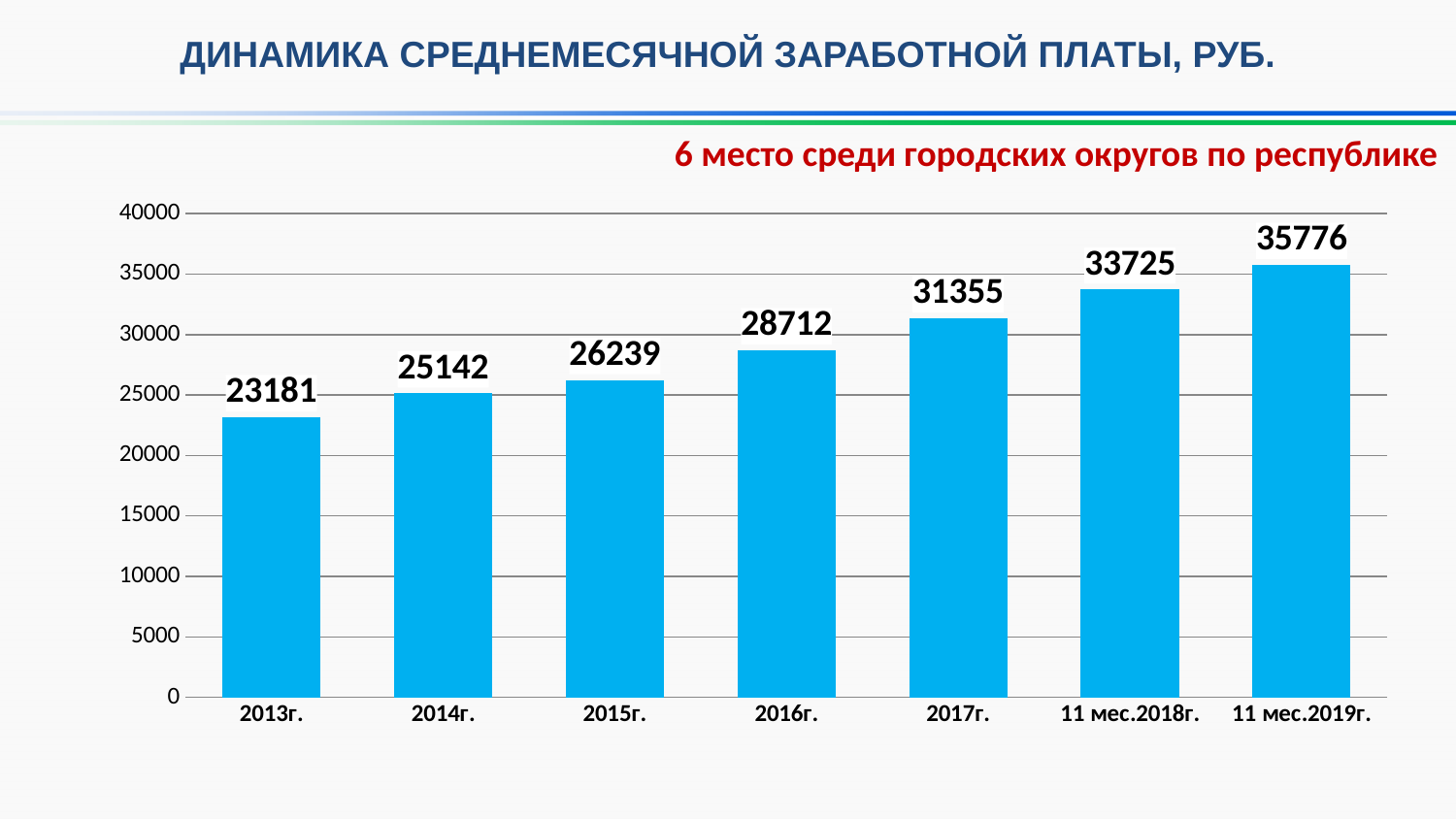
What is the average monthly salary value shown for 2013г.? 23181 Which category has the lowest value? 2013г. Which category has the highest value? 11 мес.2019г. What is the difference between the values for 11 мес.2019г. and 11 мес.2018г.? 2051 How many categories are shown on the x axis? 7 Do the values rise or fall from 2013г. to 11 мес.2019г.? rise Which is larger, the value for 2015г. or the value for 2014г.? 2015г. Is the value for 2017г. greater or less than 30000? greater What value is shown for 11 мес.2018г.? 33725 What value is shown for 2016г.? 28712 What is the difference between the values for 2017г. and 2013г.? 8174 What kind of chart is shown on the slide? bar chart